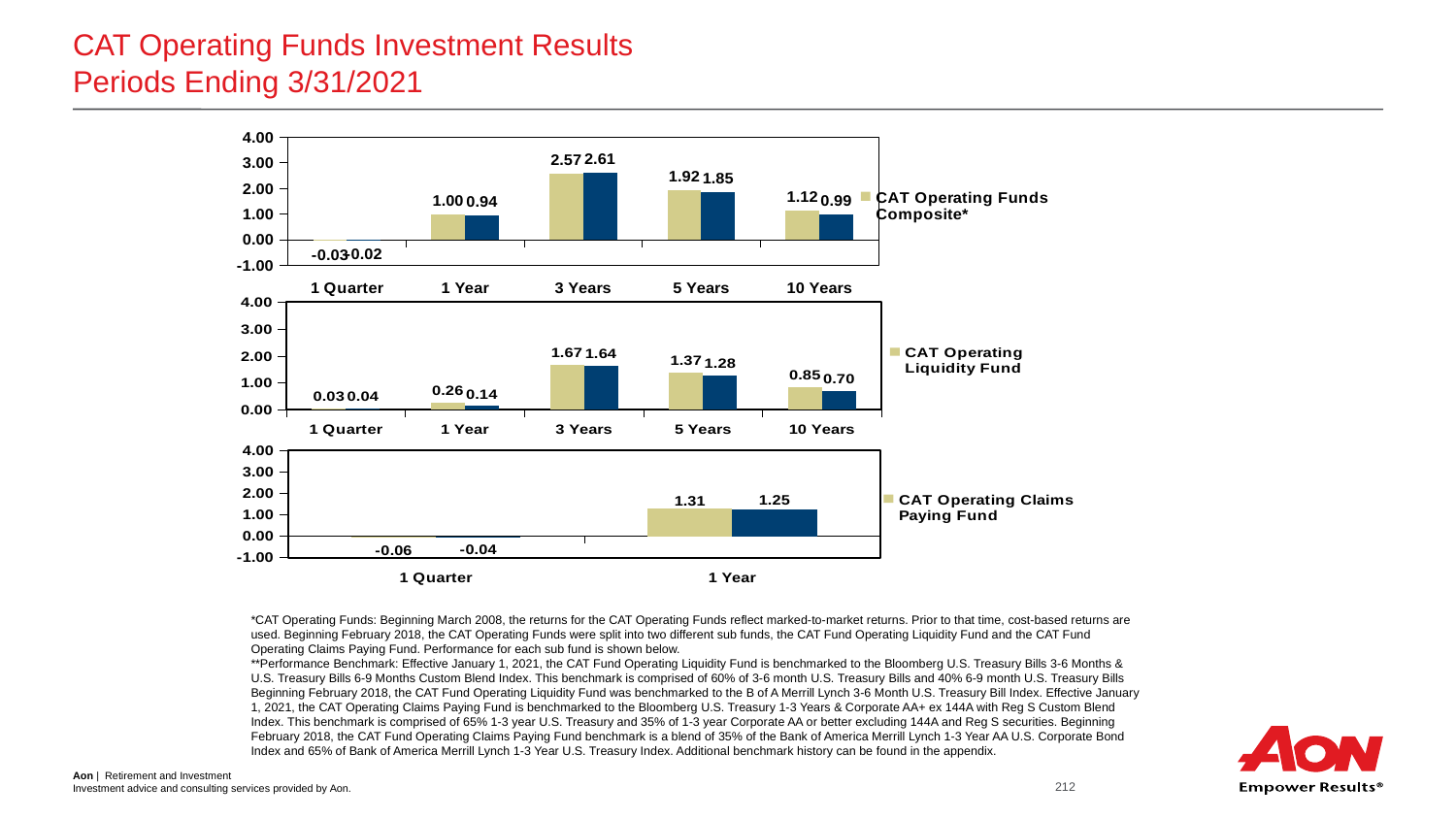
In the middle chart (CAT Operating Liquidity Fund), do the tan bar values rise or fall from 1 Quarter to 3 Years? rise In the top chart (CAT Operating Funds Composite), which period has the highest tan bar value? 3 Years In the bottom chart (CAT Operating Claims Paying Fund), what is the value of the tan bar for 1 Quarter? -0.06 In the top chart (CAT Operating Funds Composite), what is the value of the tan bar for 3 Years? 2.57 In the top chart (CAT Operating Funds Composite), what is the value of the dark blue bar for 10 Years? 0.99 In the middle chart (CAT Operating Liquidity Fund), what is the value of the tan bar for 1 Year? 0.26 In the middle chart (CAT Operating Liquidity Fund), which is larger for 10 Years, the tan bar or the dark blue bar? the tan bar In the middle chart (CAT Operating Liquidity Fund), what is the difference between the tan bar and the dark blue bar for 1 Year? 0.12 In the bottom chart (CAT Operating Claims Paying Fund), how many periods are shown on the x axis? 2 In the top chart (CAT Operating Funds Composite), which period has the lowest tan bar value? 1 Quarter What type of chart is the top chart (CAT Operating Funds Composite)? bar chart In the top chart (CAT Operating Funds Composite), what is the difference between the tan bar and the dark blue bar for 5 Years? 0.07